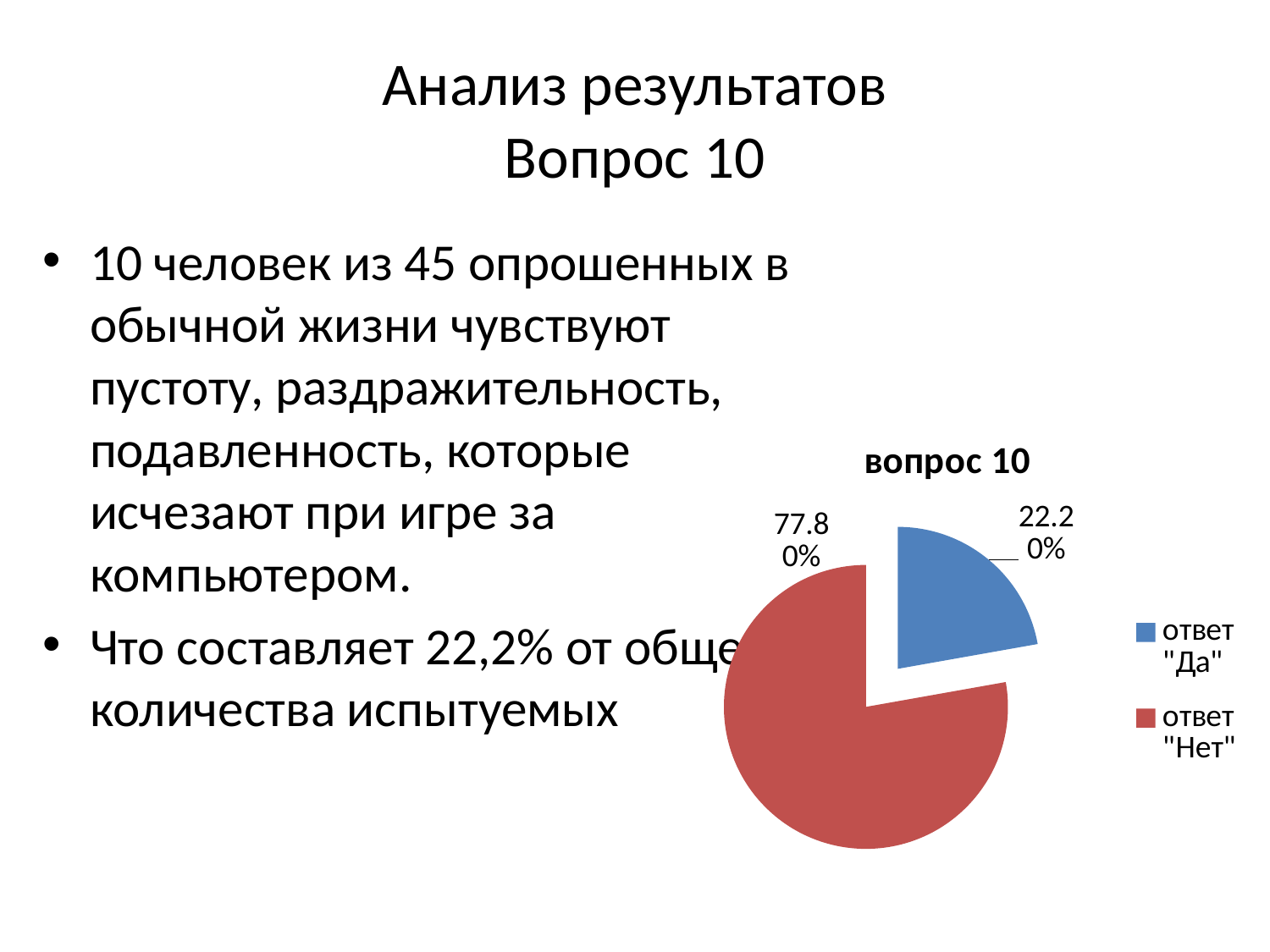
Which slice is the largest in the pie chart? ответ "Нет" Which is larger, the slice for ответ "Да" or the slice for ответ "Нет"? ответ "Нет" What is the title of the chart? вопрос 10 What value is printed on the slice for ответ "Да"? 22.20% What value is printed on the slice for ответ "Нет"? 77.80% What type of chart is shown on the slide? pie chart Which slice is the smallest in the pie chart? ответ "Да" How many slices does the pie chart have? 2 How many entries does the chart legend list? 2 What is the difference between the printed values for ответ "Нет" and ответ "Да"? 55.60% What colour is the slice for ответ "Да"? blue